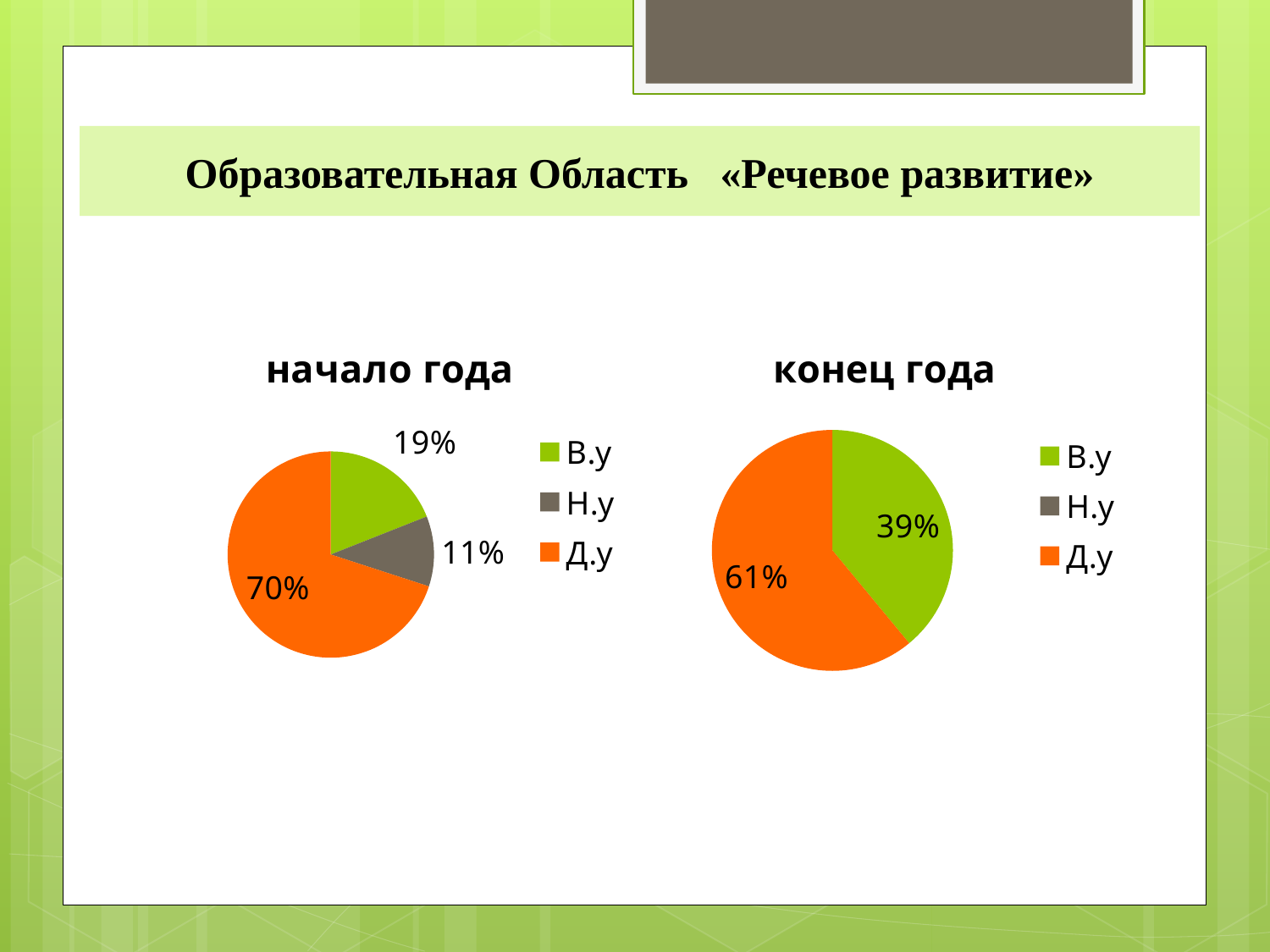
In the "конец года" chart, which is larger, В.у or Д.у? Д.у In the "начало года" chart, which category has the largest slice? Д.у What is the difference between the В.у value in the "конец года" chart and the В.у value in the "начало года" chart? 20% In the "начало года" chart, what is the value for Д.у? 70% In the "начало года" chart, which category has the smallest slice? Н.у In the "конец года" chart, what is the value for Д.у? 61% What type of chart is the "конец года" chart? Pie chart How many entries does the legend of the "начало года" chart list? 3 In the "начало года" chart, what is the value for В.у? 19% In the "начало года" chart, what is the difference between Д.у and В.у? 51% In the "конец года" chart, what is the value for В.у? 39% In the "начало года" chart, what is the value for Н.у? 11%